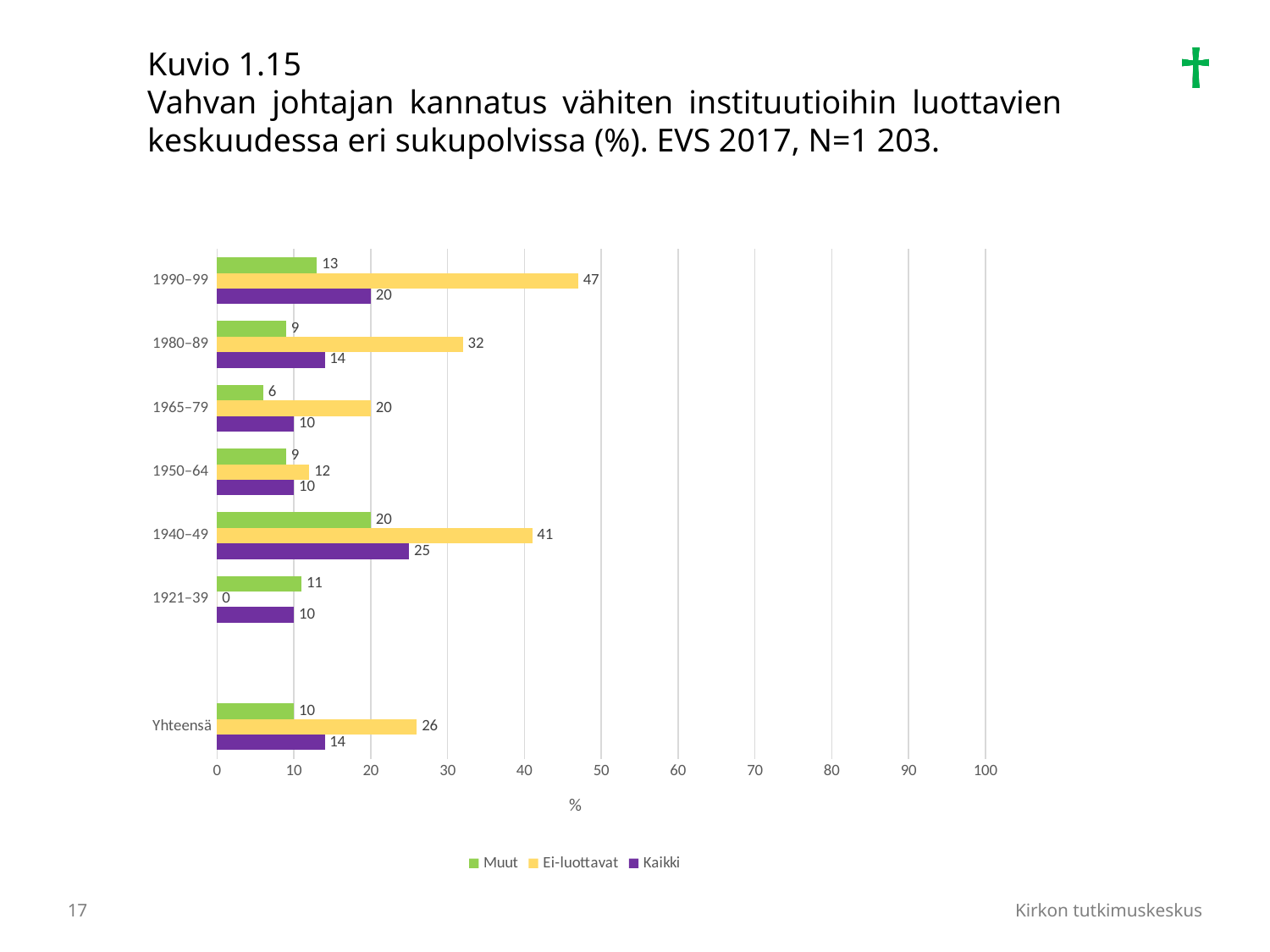
What is the Muut value for Yhteensä? 10 What is the difference between the Ei-luottavat and Kaikki values for the 1940–49 generation? 16 How many categories are shown on the vertical axis? 7 Which series is shown in yellow? Ei-luottavat Is the Ei-luottavat value for the 1980–89 generation greater or less than 30? greater What kind of chart is shown on the slide? Bar chart Which generation has the highest Ei-luottavat value? 1990–99 Which generation has the lowest Ei-luottavat value? 1921–39 What is the Kaikki value for the 1980–89 generation? 14 Which is larger for the 1950–64 generation, the Muut value or the Ei-luottavat value? Ei-luottavat What is the Ei-luottavat value for the 1990–99 generation? 47 How many series does the legend list? 3